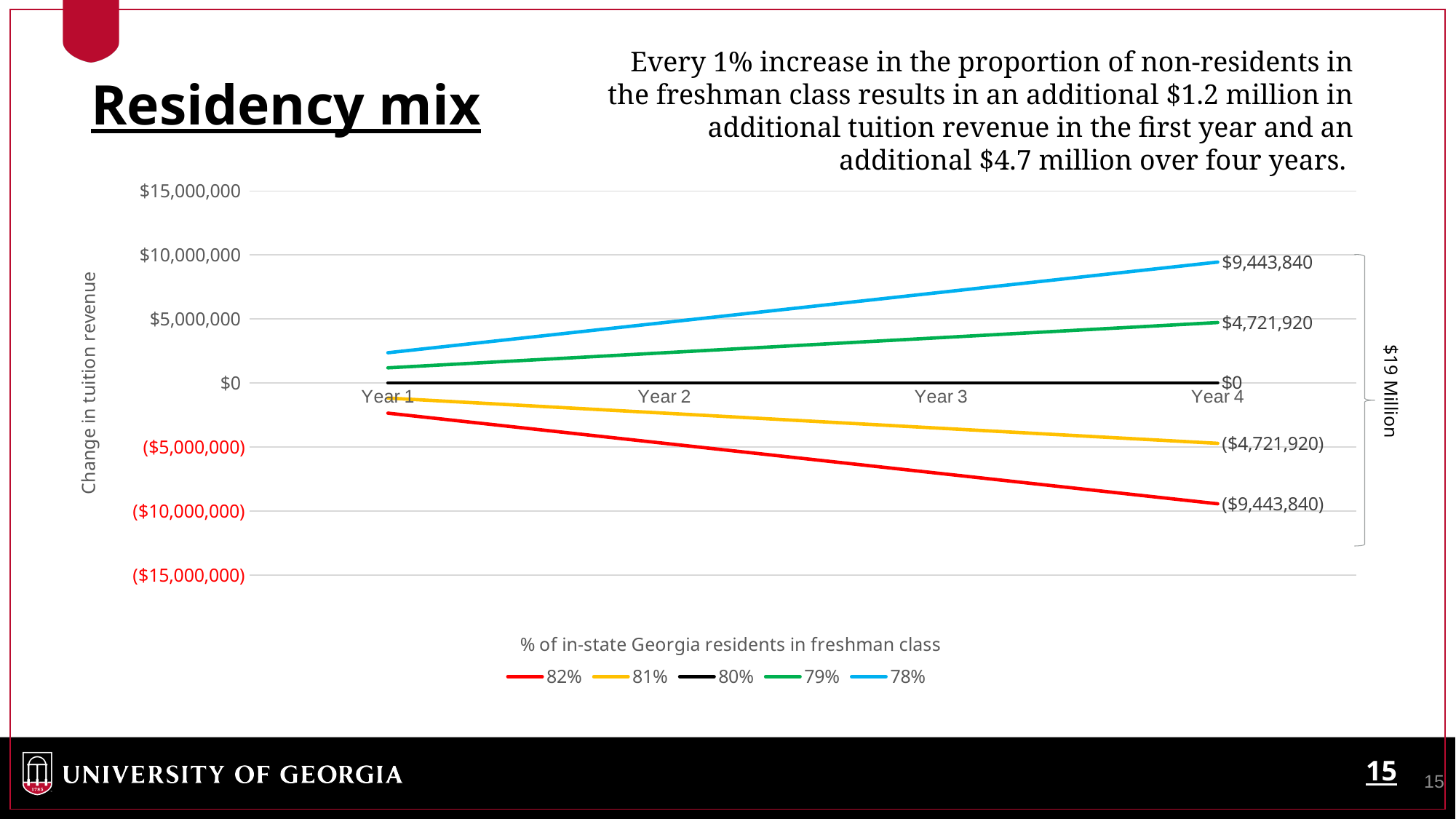
What is the title of the chart's legend? % of in-state Georgia residents in freshman class How many years are shown on the x axis of the chart? 4 What type of chart is shown on the slide? line chart How many series does the chart legend list? 5 What is the difference between the Year 4 values of the 78% series and the 79% series? $4,721,920 What is the change in tuition revenue in Year 4 for the 78% series? $9,443,840 What is the change in tuition revenue in Year 4 for the 79% series? $4,721,920 Which series has the lowest change in tuition revenue in Year 4? 82% What is the change in tuition revenue in Year 4 for the 82% series? ($9,443,840) What is the change in tuition revenue in Year 4 for the 80% series? $0 Which series has the highest change in tuition revenue in Year 4? 78% Does the 82% series rise or fall from Year 1 to Year 4? fall